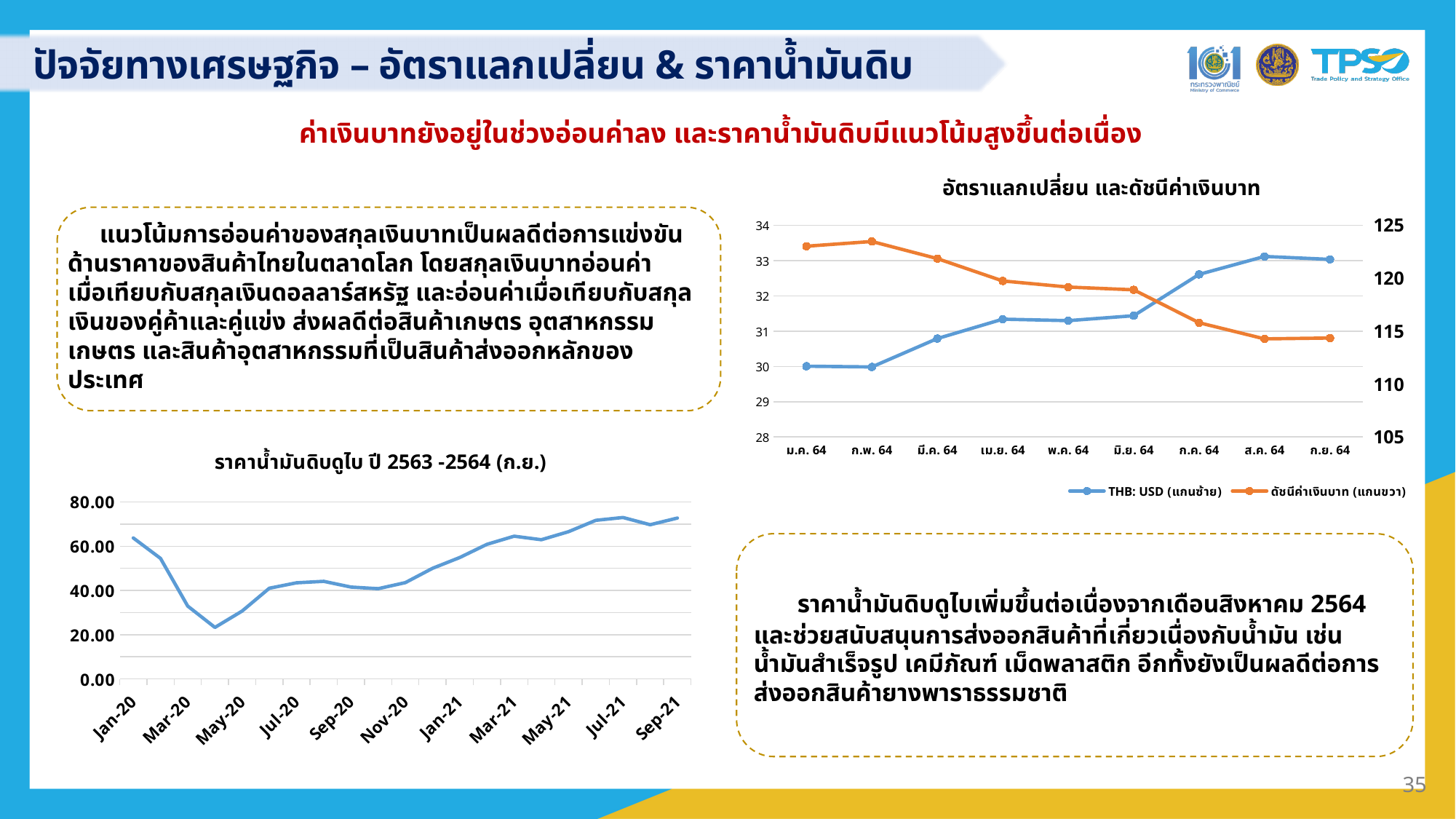
In the chart titled "อัตราแลกเปลี่ยน และดัชนีค่าเงินบาท", is the THB: USD value for ม.ค. 64 greater or less than 31? less In the chart titled "อัตราแลกเปลี่ยน และดัชนีค่าเงินบาท", does the ดัชนีค่าเงินบาท series rise or fall from ม.ค. 64 to ก.ย. 64? Fall In the chart titled "อัตราแลกเปลี่ยน และดัชนีค่าเงินบาท", is the THB: USD value for ส.ค. 64 greater or less than 32? greater In the chart titled "อัตราแลกเปลี่ยน และดัชนีค่าเงินบาท", is the ดัชนีค่าเงินบาท value for ก.ย. 64 greater or less than 120? less In the chart titled "อัตราแลกเปลี่ยน และดัชนีค่าเงินบาท", how many series does the legend list? 2 What kind of chart is the chart titled "อัตราแลกเปลี่ยน และดัชนีค่าเงินบาท"? Line chart In the chart titled "อัตราแลกเปลี่ยน และดัชนีค่าเงินบาท", which is larger for THB: USD, เม.ย. 64 or ก.ค. 64? ก.ค. 64 In the chart titled "อัตราแลกเปลี่ยน และดัชนีค่าเงินบาท", does the THB: USD series rise or fall from ม.ค. 64 to ก.ย. 64? Rise In the chart titled "อัตราแลกเปลี่ยน และดัชนีค่าเงินบาท", how many months are shown on the x axis? 9 What kind of chart is the chart titled "ราคาน้ำมันดิบดูไบ ปี 2563 -2564 (ก.ย.)"? Line chart